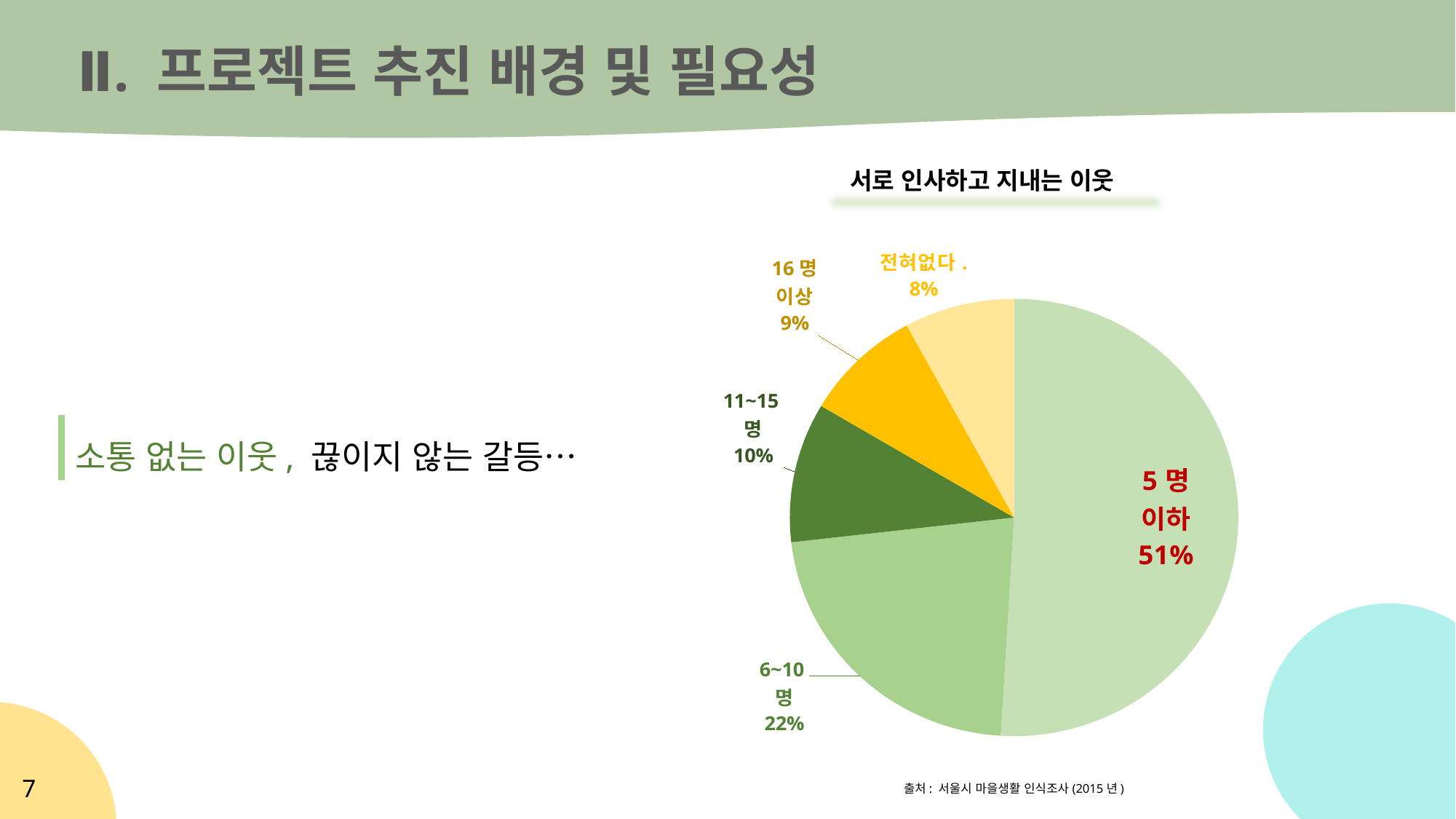
What kind of chart is shown on the slide? pie chart What is the value shown for '11~15명'? 10% How many slices does the pie chart have? 5 What is the title of the chart? 서로 인사하고 지내는 이웃 What share of the pie does the '5명 이하' slice represent? 51% Which category has the largest slice of the pie? 5명 이하 Which category has the smallest slice of the pie? 전혀없다 What is the difference in percentage points between '5명 이하' and '6~10명'? 29 Which is larger, the slice for '6~10명' or the slice for '11~15명'? 6~10명 What is the value shown for '16명 이상'? 9% What share of the pie does the '6~10명' slice represent? 22% What is the value shown for '전혀없다'? 8%